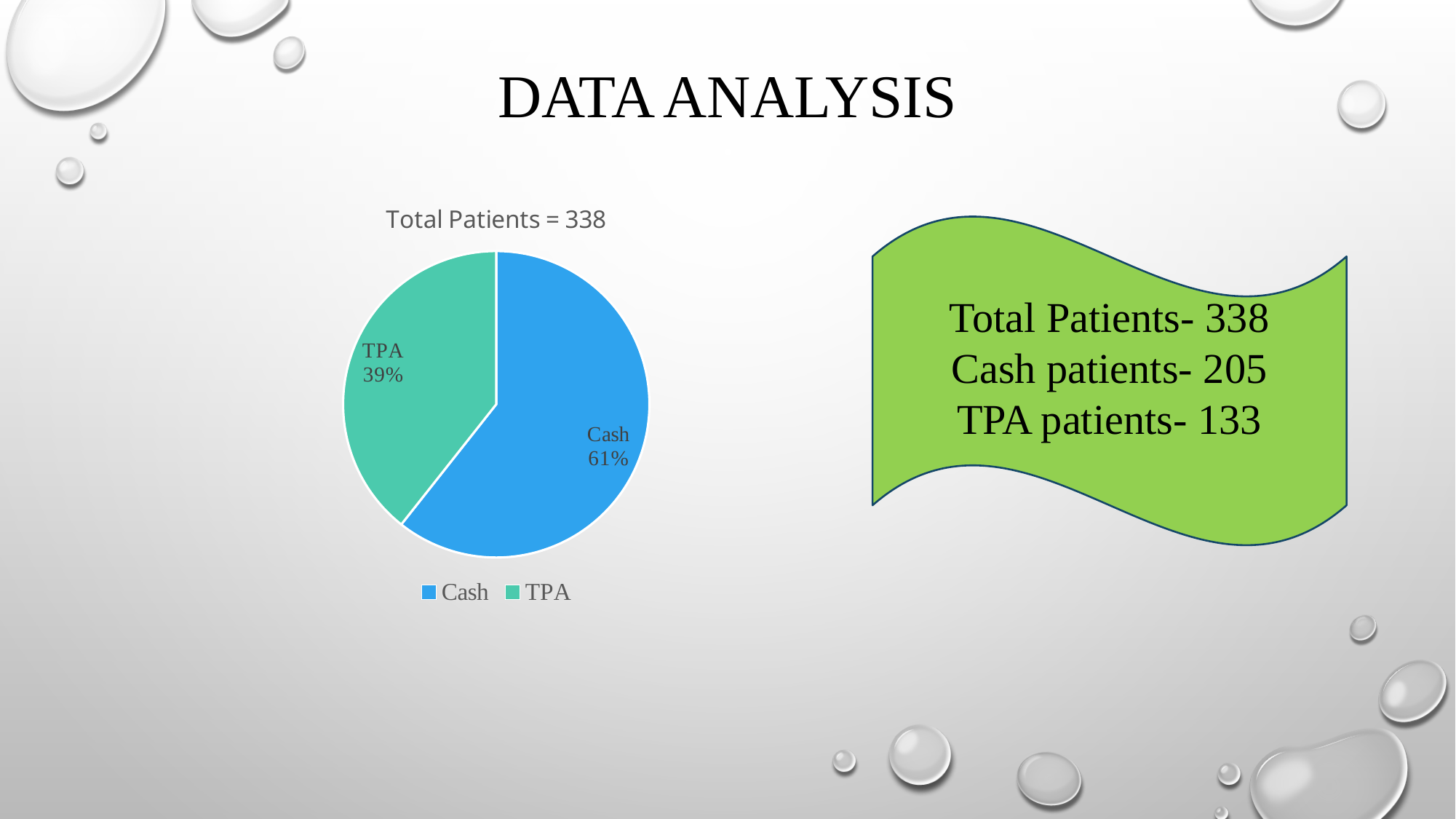
Which slice of the pie chart is the largest? Cash What type of chart is shown on the slide? pie chart Which is larger in the pie chart, Cash or TPA? Cash What colour is the TPA slice in the pie chart? green How many slices does the pie chart have? 2 How many entries does the legend of the pie chart list? 2 What percentage of the pie does the Cash slice represent? 61% Which slice of the pie chart is the smallest? TPA What percentage of the pie does the TPA slice represent? 39% What is the title of the pie chart? Total Patients = 338 Is the share for Cash greater or less than 50%? greater What is the difference in percentage points between the Cash and TPA slices? 22 percentage points